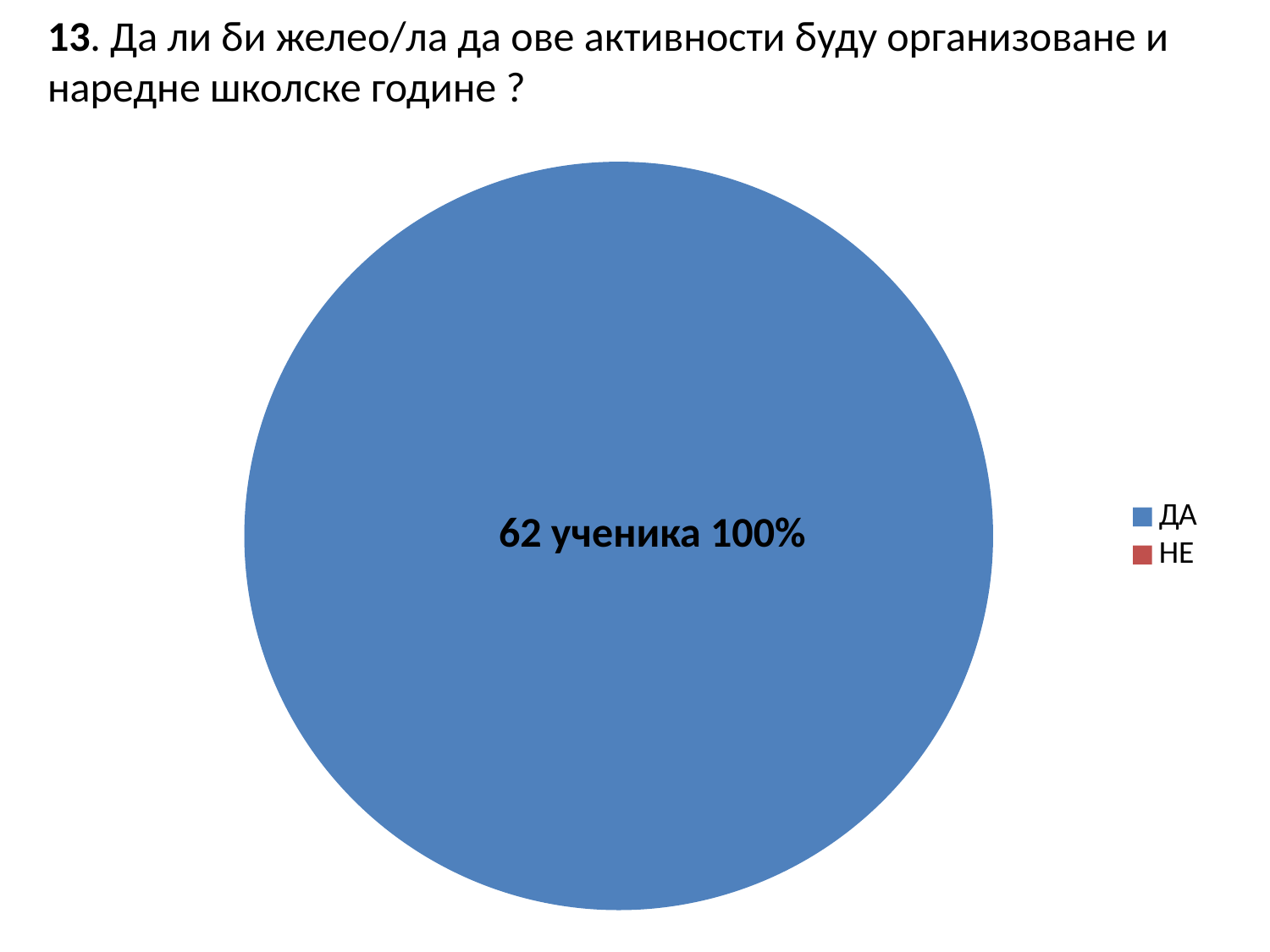
What colour is the ДА slice in the pie chart? blue What kind of chart is shown on the slide? pie chart What are the two categories listed in the legend of the pie chart? ДА and НЕ Which of the two categories, ДА or НЕ, has the larger share of the pie? ДА How many entries does the legend of the pie chart list? 2 How many students are shown in the ДА slice of the pie chart? 62 ученика What share of the pie does the ДА slice represent? 100% Which category has the largest share of the pie chart? ДА What is the data label printed on the pie chart? 62 ученика 100%